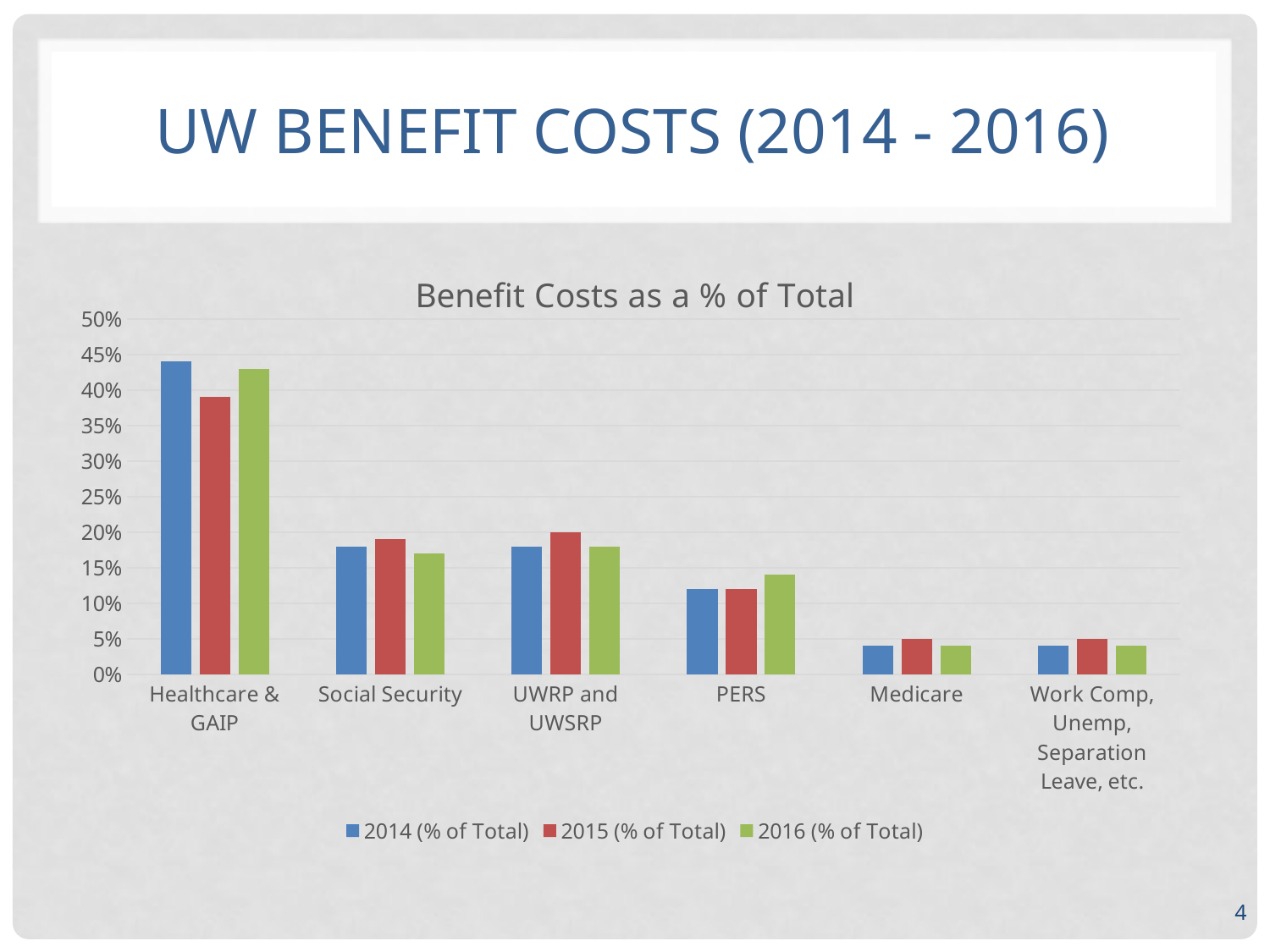
Is the 2014 value for Healthcare & GAIP greater or less than 40%? greater Does the value for PERS rise or fall from 2015 to 2016? rise For Social Security, which is larger: the 2015 value or the 2016 value? 2015 (% of Total) What is the 2015 value for UWRP and UWSRP? 20% For Healthcare & GAIP, which year has the lowest value? 2015 (% of Total) What is the title of the chart? Benefit Costs as a % of Total Is the 2016 value for PERS greater or less than 10%? greater How many benefit categories are shown on the x axis? 6 Which benefit category has the highest share of total costs? Healthcare & GAIP How many series does the legend list? 3 What kind of chart is shown on the slide? bar chart Is the 2014 value for Social Security greater or less than 20%? less